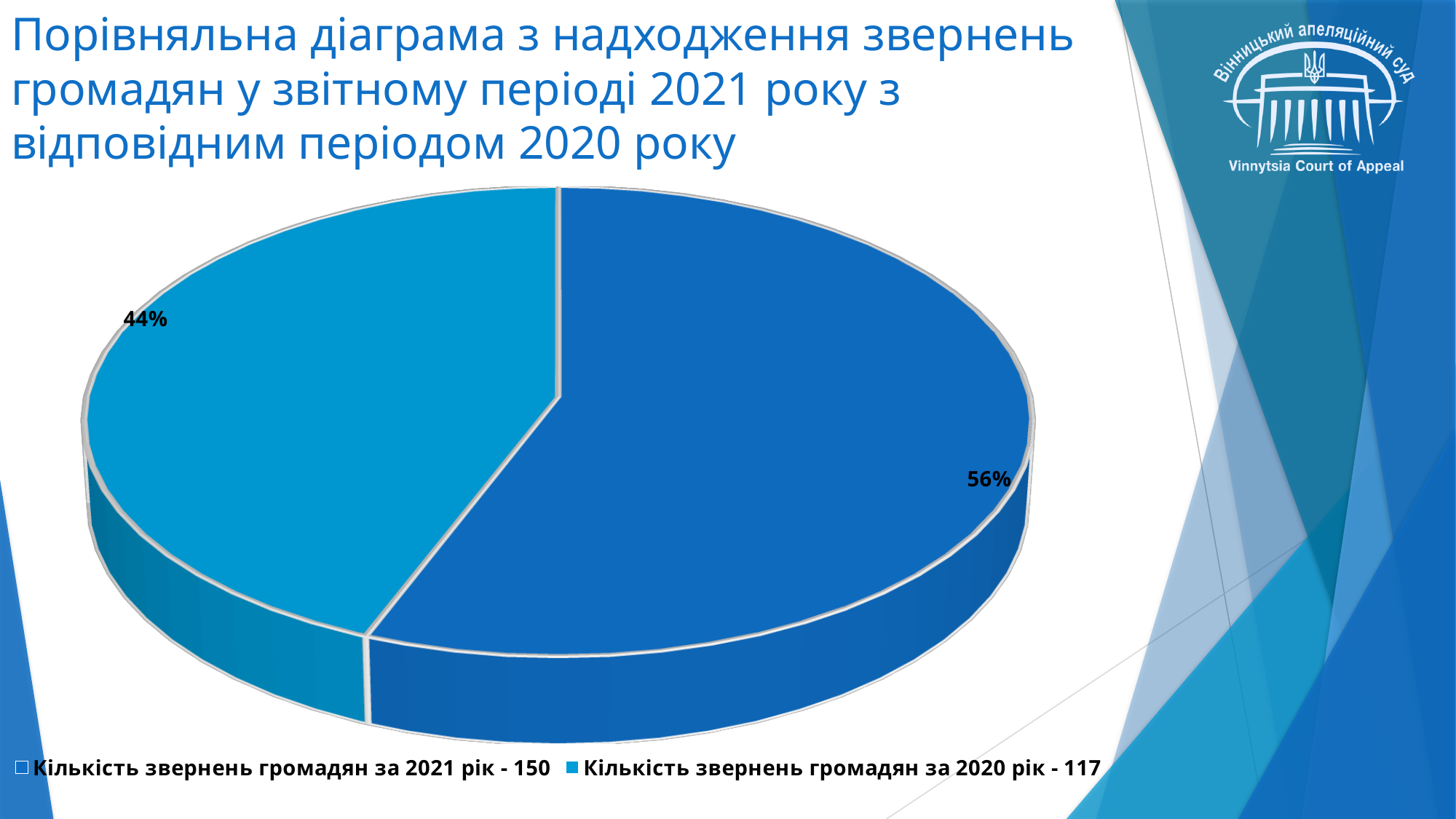
How many entries does the legend list? 2 Which year has the smallest share of the pie? 2020 What is the difference between the number of appeals in 2021 and in 2020? 33 How many appeals from citizens were received in 2020 according to the legend? 117 How many appeals from citizens were received in 2021 according to the legend? 150 Which slice is shown in the lighter blue colour, 2021 or 2020? 2020 Which year has the larger slice of the pie, 2021 or 2020? 2021 How many slices does the pie chart have? 2 What share of the pie does the slice for citizens' appeals in 2020 (Кількість звернень громадян за 2020 рік) represent? 44% What share of the pie does the slice for citizens' appeals in 2021 (Кількість звернень громадян за 2021 рік) represent? 56% What is the combined number of appeals for 2021 and 2020 shown in the legend? 267 What kind of chart is shown on the slide? pie chart